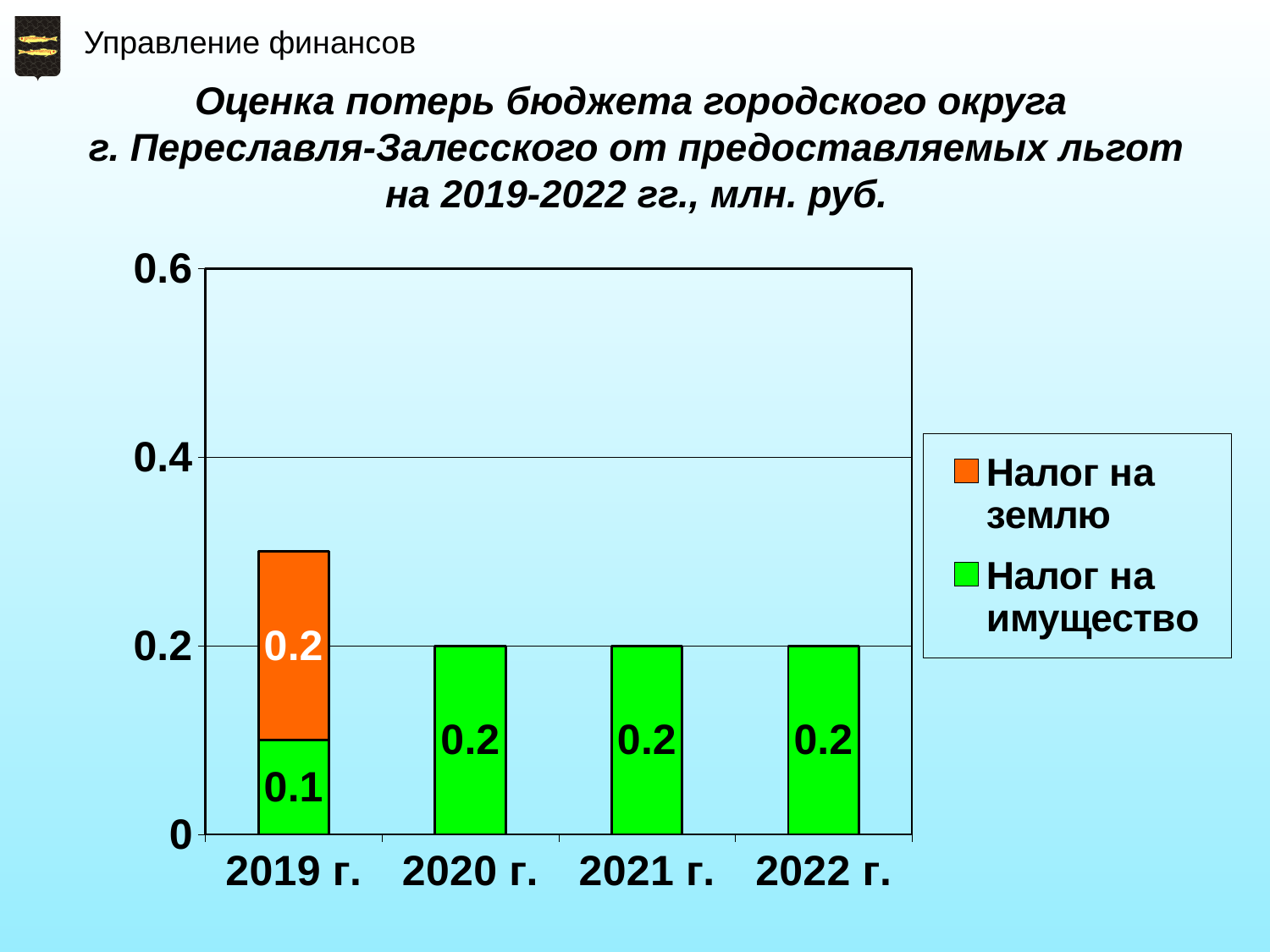
Which year has the highest total bar? 2019 г. What is the total of the stacked bar for 2019 г.? 0.3 What is the value for Налог на землю in 2019 г.? 0.2 How many series does the legend list? 2 What is the value for Налог на имущество in 2021 г.? 0.2 Which colour represents Налог на землю in the legend? orange What is the value for Налог на имущество in 2019 г.? 0.1 How many years are shown on the x axis? 4 Is the total bar for 2019 г. greater or less than 0.4? less What kind of chart is shown on the slide? stacked bar chart What is the difference between Налог на имущество in 2020 г. and in 2019 г.? 0.1 Which is larger in 2019 г.: Налог на землю or Налог на имущество? Налог на землю